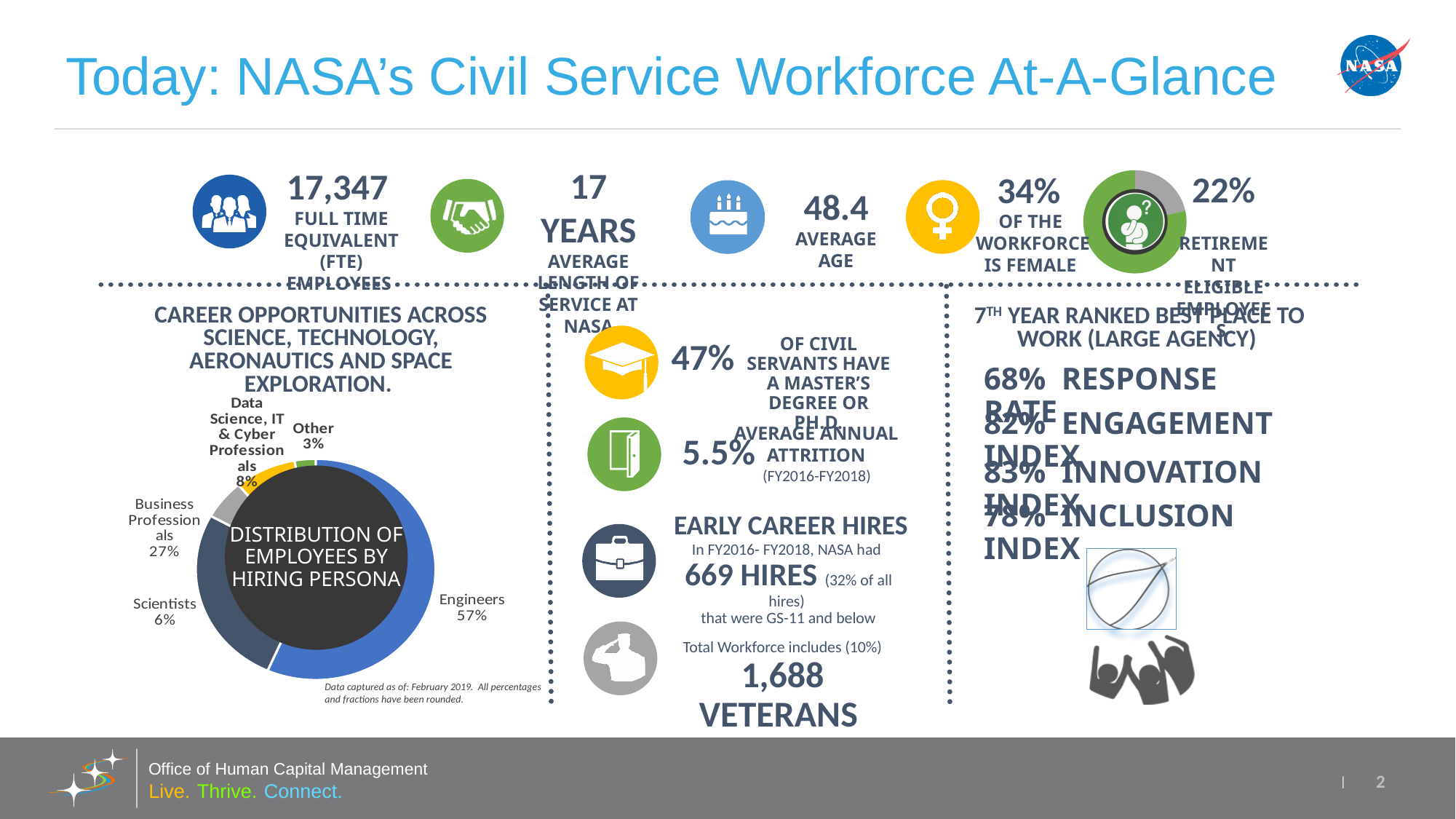
In the 'Distribution of Employees by Hiring Persona' chart, how many percentage points larger is the Engineers share than the Business Professionals share? 30 percentage points In the 'Distribution of Employees by Hiring Persona' chart, which is larger: the Scientists share or the Data Science, IT & Cyber Professionals share? Data Science, IT & Cyber Professionals In the 'Distribution of Employees by Hiring Persona' chart, what share falls under Other? 3% How many categories (hiring personas) are shown in the 'Distribution of Employees by Hiring Persona' chart? 5 In the 'Distribution of Employees by Hiring Persona' chart, what share of employees are Engineers? 57% In the 'Distribution of Employees by Hiring Persona' chart, what share of employees are Data Science, IT & Cyber Professionals? 8% Which hiring persona has the smallest share in the 'Distribution of Employees by Hiring Persona' chart? Other Which hiring persona has the largest share in the 'Distribution of Employees by Hiring Persona' chart? Engineers What title is printed in the centre of the doughnut chart on the left of the slide? Distribution of Employees by Hiring Persona What kind of chart is the 'Distribution of Employees by Hiring Persona' chart? Doughnut (pie) chart In the 'Distribution of Employees by Hiring Persona' chart, what share of employees are Business Professionals? 27% In the 'Distribution of Employees by Hiring Persona' chart, what share of employees are Scientists? 6%